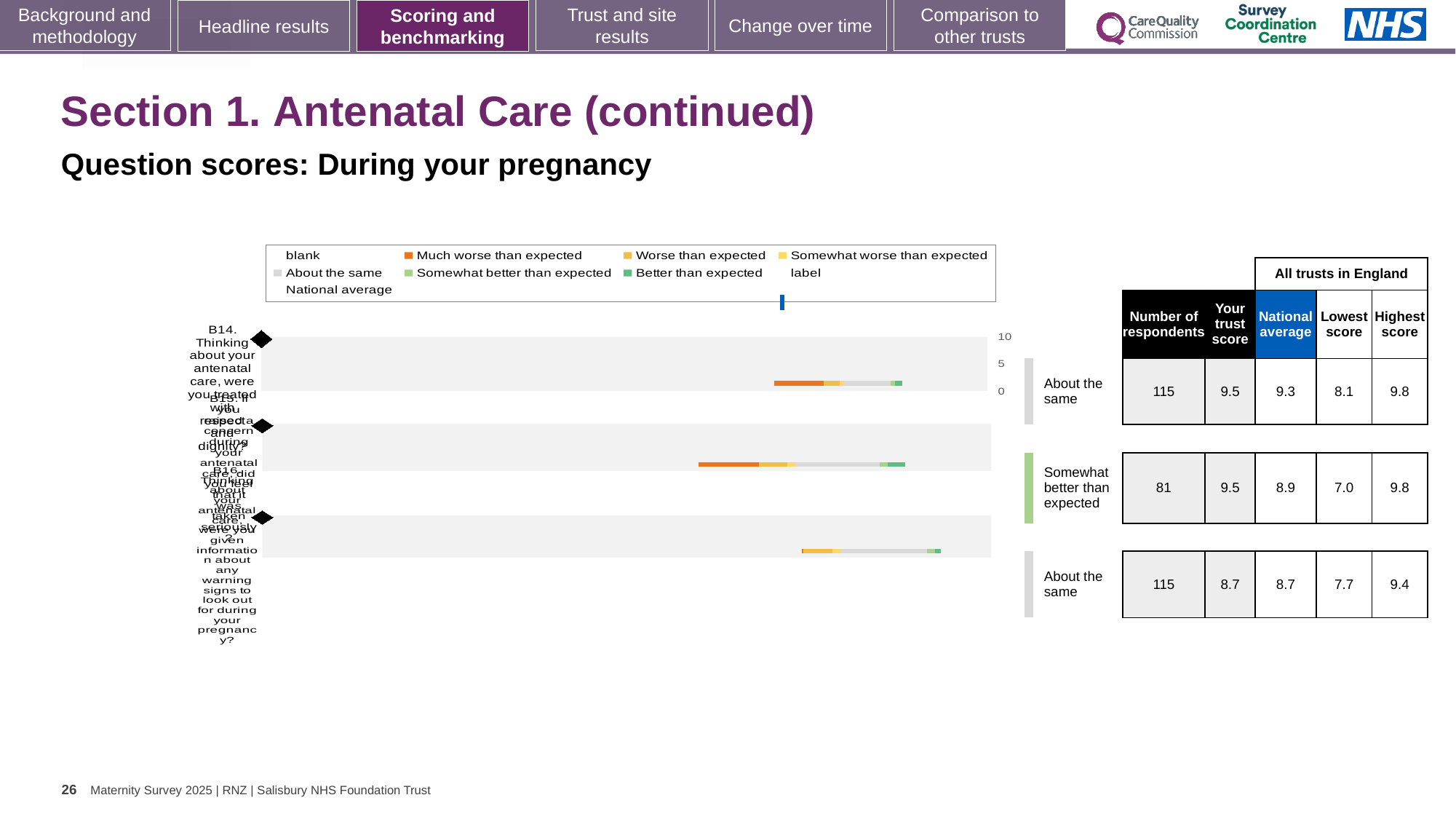
According to the table beside the chart, how many respondents answered the first (top) question, B14? 115 What is the highest score across all trusts in England for the first (top) question row? 9.8 How many question bars are plotted in the chart? 3 For the second question row, how much higher is the trust score than the national average? 0.6 What type of chart is shown on the slide? bar chart Which question row has the lowest 'Lowest score' value in the table? the second row Which has the higher national average: the first (top) question row or the third (bottom) question row? the first (top) row In the chart legend, which colour represents 'Much worse than expected'? orange What is the national average for the third (bottom) question row in the table beside the chart? 8.7 What benchmark category is given for the second question row? Somewhat better than expected What is the lowest score across all trusts in England for the second question row? 7.0 What is the trust score for the second question row in the table beside the chart? 9.5